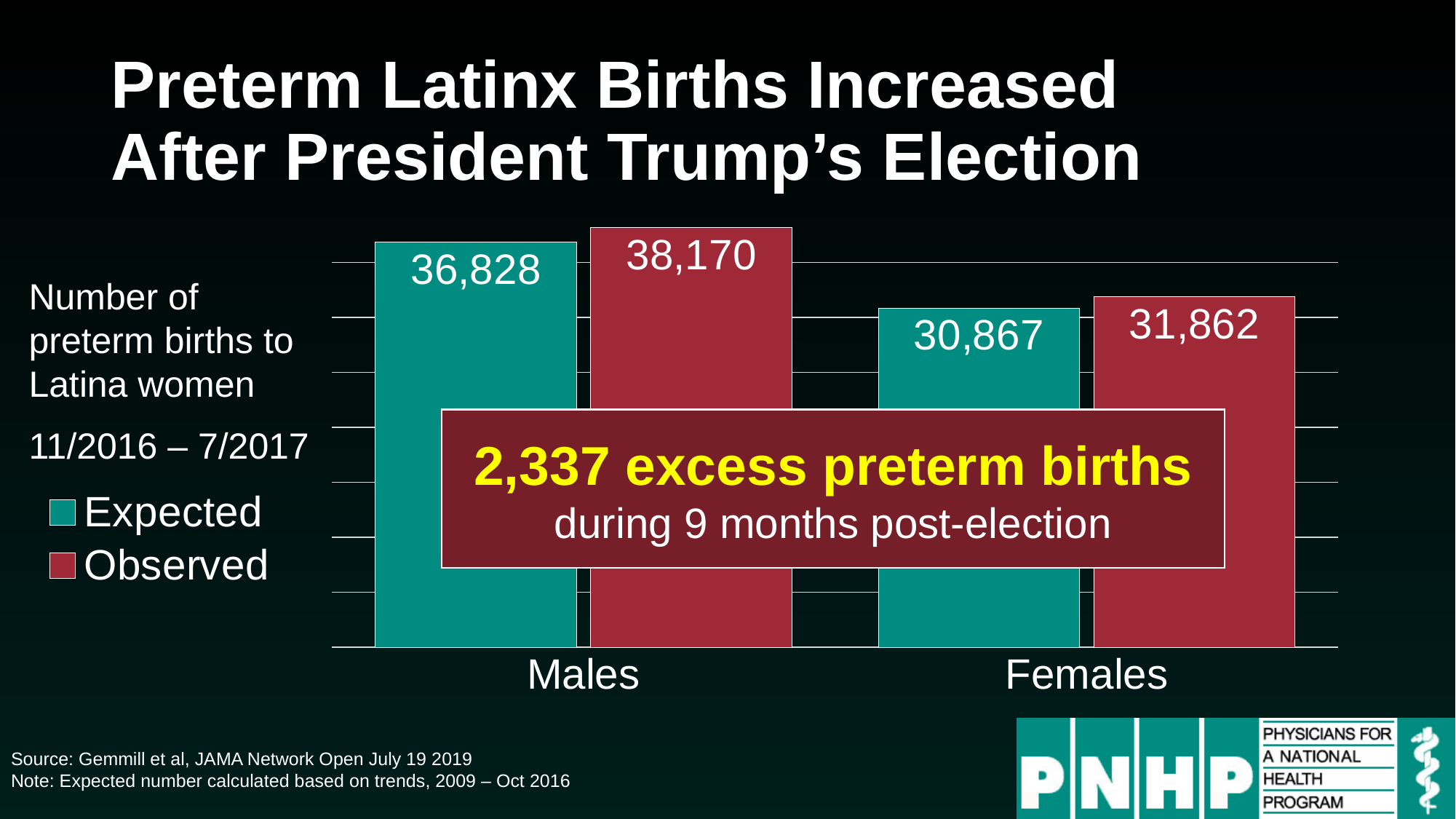
What is the expected number of preterm births for Males? 36,828 What is the observed number of preterm births for Males? 38,170 Which bar shows the lowest value on the chart? Expected, Females Is the observed value for Females larger or smaller than the expected value for Females? larger What is the difference between the observed and expected preterm births for Males? 1,342 How many series does the legend list? 2 How many categories are shown on the x axis? 2 What is the observed number of preterm births for Females? 31,862 What is the expected number of preterm births for Females? 30,867 Which bar shows the highest value on the chart? Observed, Males What kind of chart is shown on the slide? bar chart What is the difference between the observed and expected preterm births for Females? 995